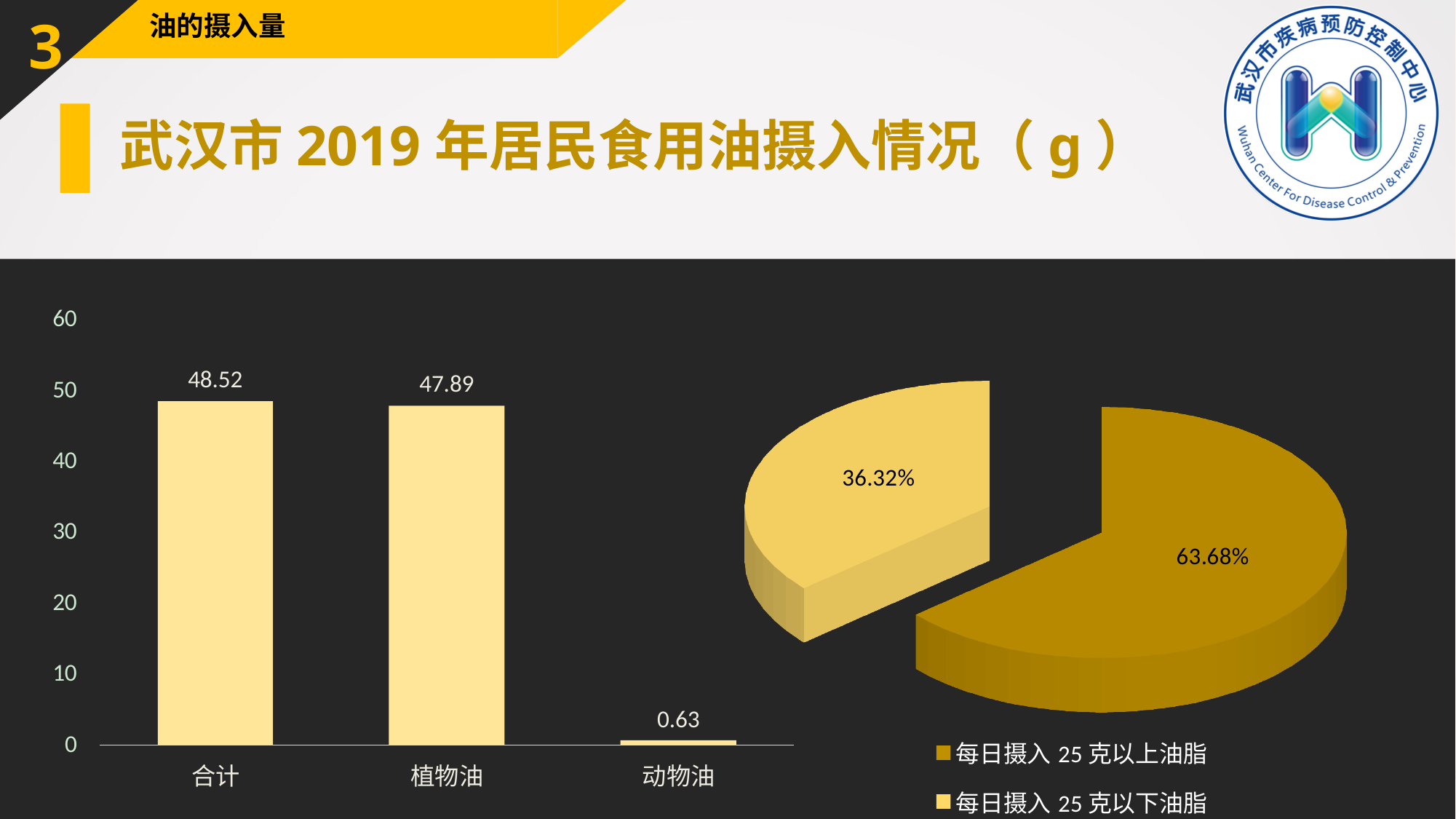
How many entries does the legend of the pie chart on the right list? 2 In the bar chart on the left, how many categories are shown on the x axis? 3 In the bar chart on the left, what is the difference between the values for 植物油 and 动物油? 47.26 In the bar chart on the left, what is the value for 合计? 48.52 In the pie chart on the right, which slice is larger: 每日摄入 25 克以上油脂 or 每日摄入 25 克以下油脂? 每日摄入 25 克以上油脂 In the bar chart on the left, which category has the lowest value? 动物油 In the pie chart on the right, what share is labelled for 每日摄入 25 克以上油脂? 63.68% In the bar chart on the left, what is the value for 植物油? 47.89 In the pie chart on the right, what share is labelled for 每日摄入 25 克以下油脂? 36.32% What kind of chart is the chart on the left of the slide? bar chart In the bar chart on the left, which category has the highest value? 合计 In the bar chart on the left, what is the value for 动物油? 0.63